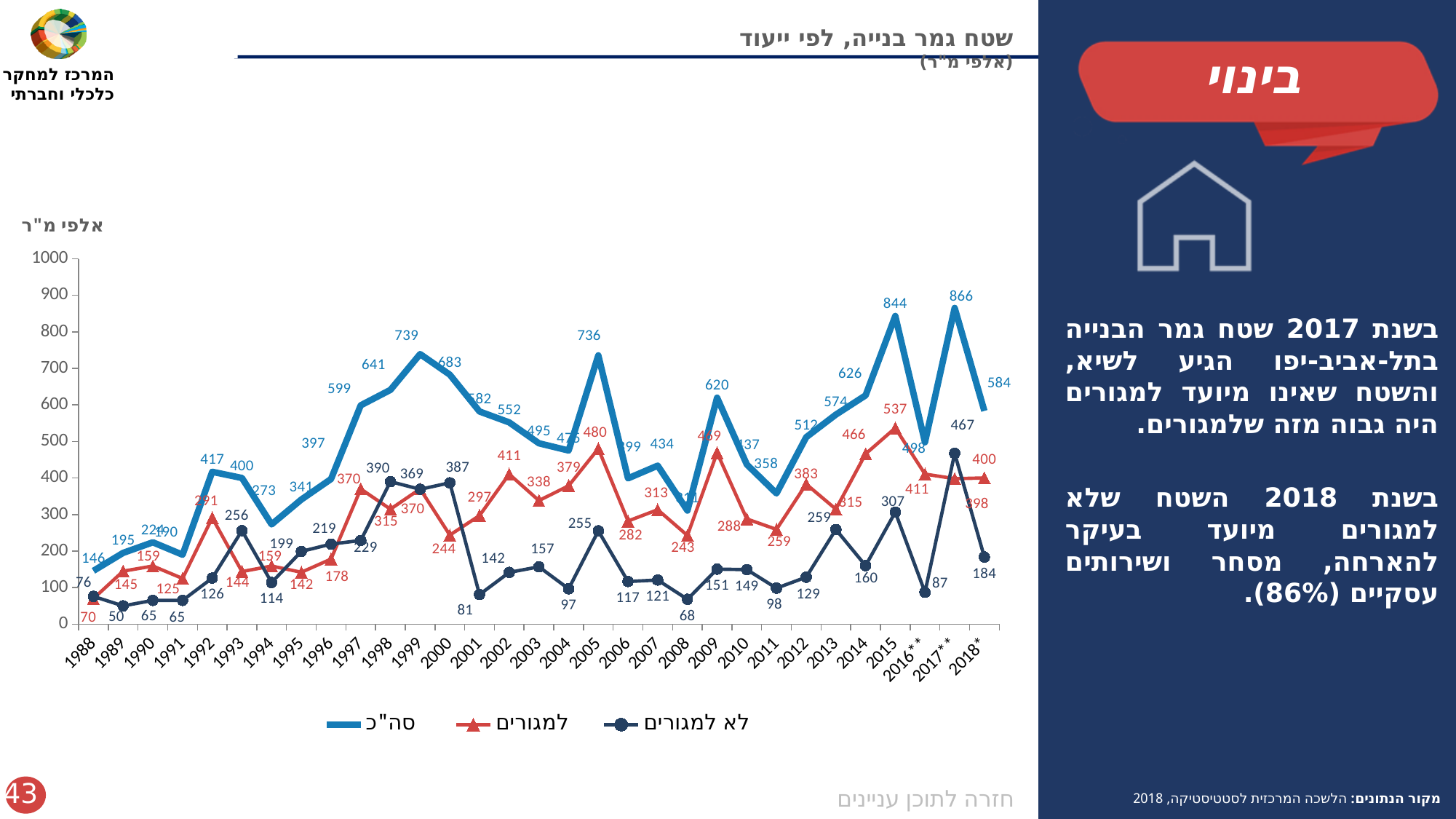
What unit is shown on the y axis label of the chart? אלפי מ"ר What is the value of the למגורים series in 2015? 537 What is the difference between the סה"כ values in 2017** and 2018*? 282 What type of chart is shown on the slide? line chart How many series does the legend list? 3 Is the סה"כ value in 2015 greater or less than 800? greater In which year does the סה"כ series reach its highest value? 2017** Which is larger in 2017**: the למגורים value or the לא למגורים value? לא למגורים What is the value of the סה"כ series in 2017**? 866 How many years are shown on the x axis? 31 In which year does the לא למגורים series have its lowest value? 1989 What is the value of the לא למגורים series in 2018*? 184